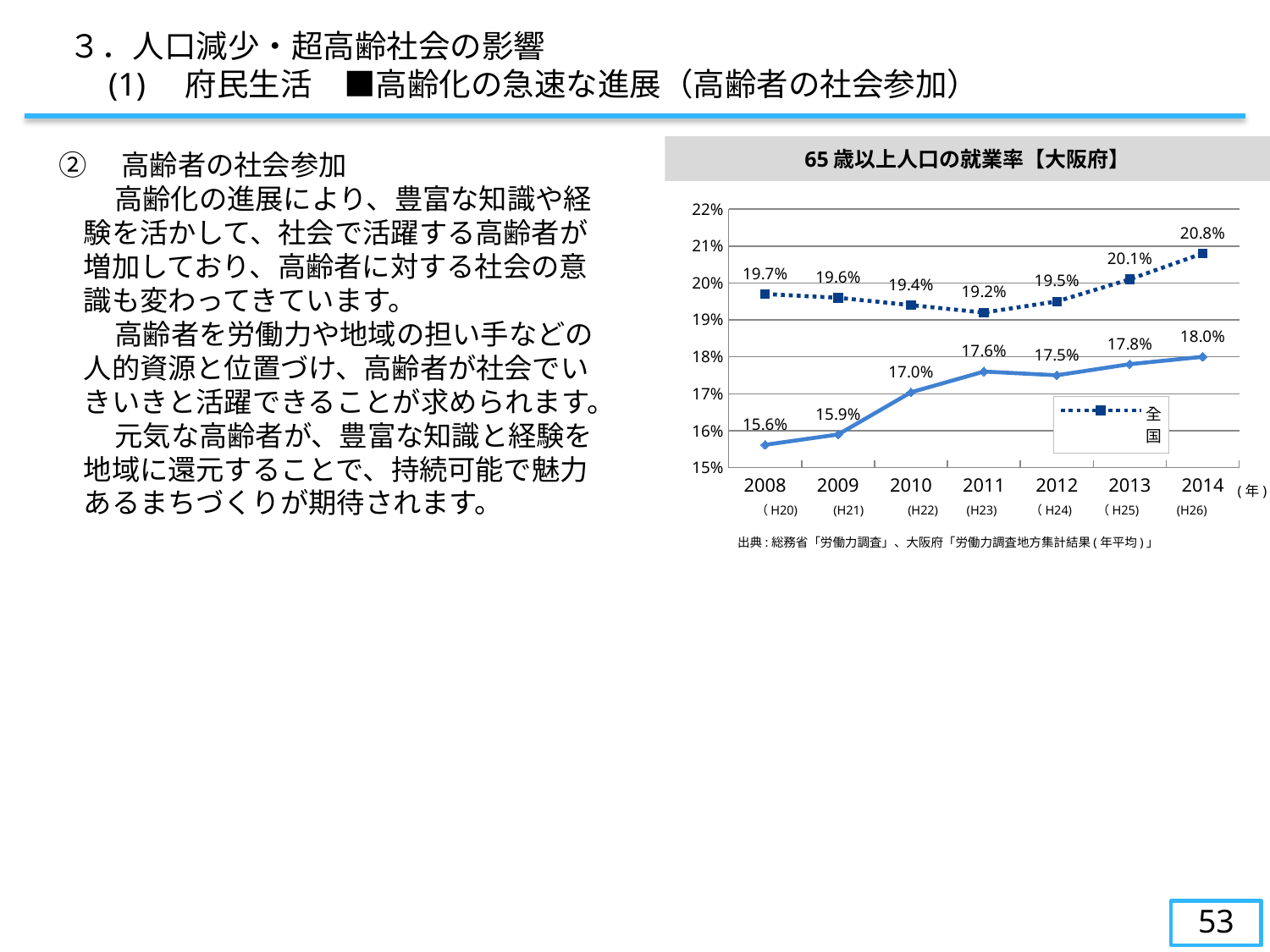
In which year is the dotted 全国 line at its lowest? 2011 Which is larger in 2010, the dotted 全国 line or the solid line? the dotted 全国 line What kind of chart is shown on the slide? line chart What is the value of the solid (lower) line in 2008? 15.6% What is the difference between the dotted 全国 line and the solid line in 2014? 2.8% Does the solid (lower) line generally rise or fall from 2008 to 2014? rise In which year is the solid (lower) line at its highest? 2014 What is the difference between the solid line's 2014 value and its 2008 value? 2.4% What is the value of the dotted 全国 line in 2011? 19.2% What is the value of the dotted 全国 line in 2014? 20.8% What is the value of the solid (lower) line in 2012? 17.5% How many years are plotted on the x axis? 7